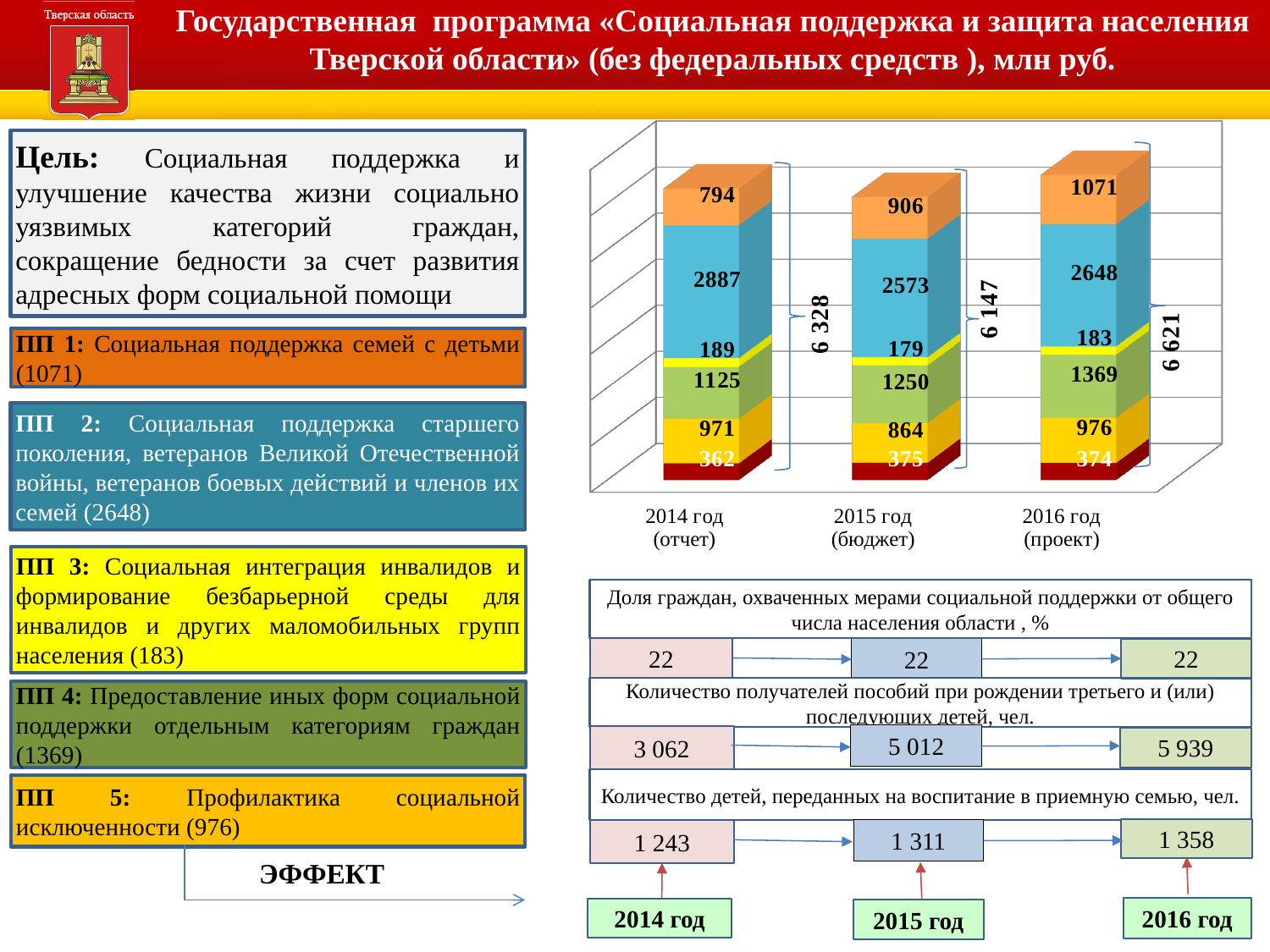
What is the total shown for the 2014 год (отчет) bar? 6 328 Which year has the highest total in the chart? 2016 год (проект) What is the difference between the totals of the 2016 год (проект) bar and the 2015 год (бюджет) bar? 474 What is the value of the blue segment of the 2014 год (отчет) bar? 2887 Which year has the lowest total in the chart? 2015 год (бюджет) What is the value of the top (orange) segment of the 2016 год (проект) bar? 1071 How many bars (years) does the chart show? 3 What is the total shown for the 2015 год (бюджет) bar? 6 147 Is the blue segment of the 2015 год (бюджет) bar larger or smaller than the blue segment of the 2016 год (проект) bar? smaller What is the total shown for the 2016 год (проект) bar? 6 621 What is the value of the bottom (dark red) segment of the 2015 год (бюджет) bar? 375 What kind of chart is shown on the slide? stacked bar chart